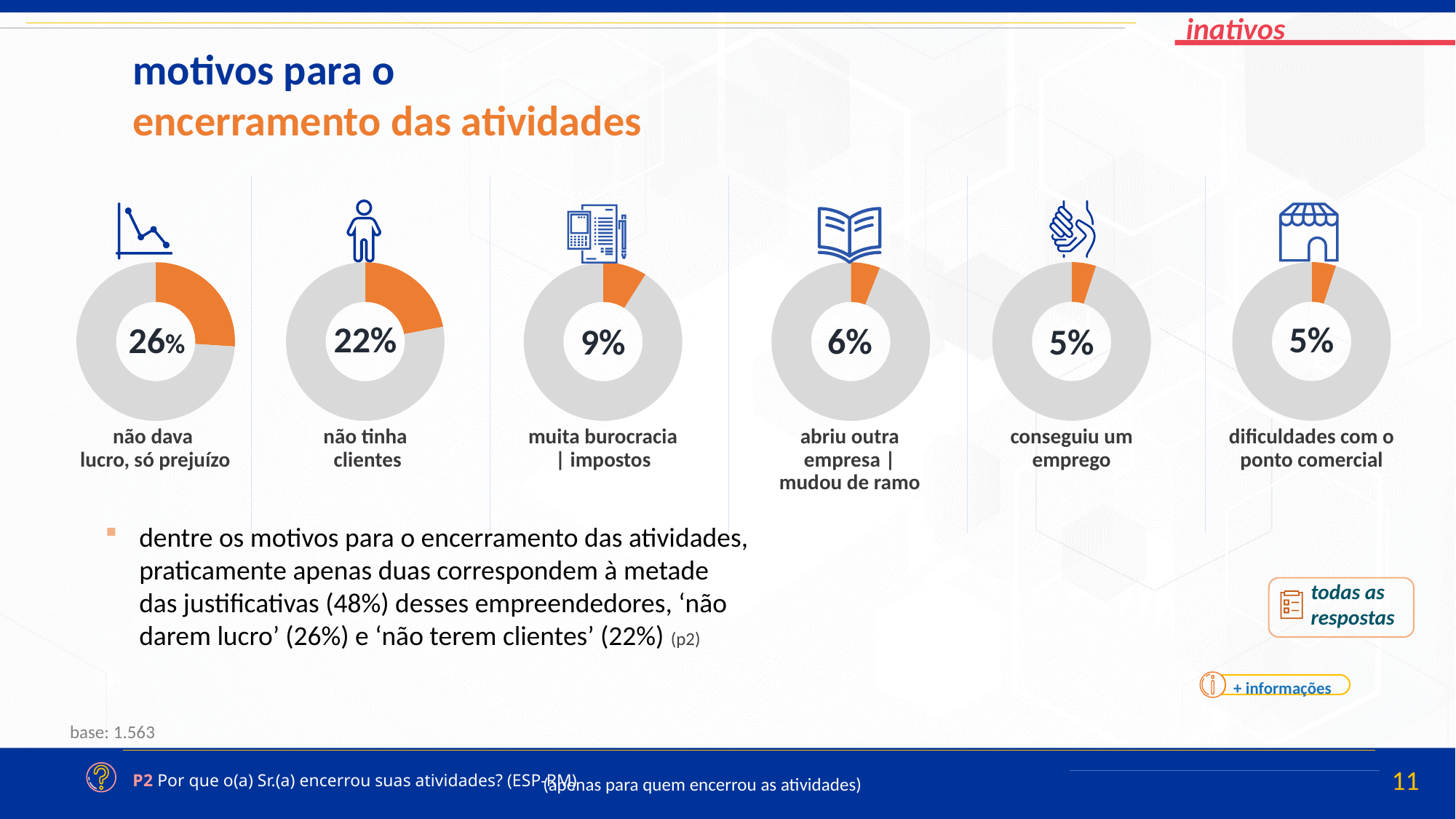
What percentage is shown in the donut chart labelled 'muita burocracia | impostos'? 9% What percentage is shown in the donut chart labelled 'não tinha clientes'? 22% What percentage is shown in the donut chart labelled 'não dava lucro, só prejuízo'? 26% What type of chart is used to display each percentage on the slide? Donut (pie) chart What is the combined percentage of the 'não dava lucro, só prejuízo' and 'não tinha clientes' charts? 48% What is the difference in percentage points between the 'não dava lucro, só prejuízo' chart and the 'não tinha clientes' chart? 4 Which is larger: the percentage for 'muita burocracia | impostos' or for 'abriu outra empresa | mudou de ramo'? muita burocracia | impostos How many donut charts are shown on the slide? 6 What colour is used for the highlighted slice in each donut chart? Orange Which reason for closing activities has the highest percentage among the donut charts? não dava lucro, só prejuízo What percentage is shown in the donut chart labelled 'conseguiu um emprego'? 5% What percentage is shown in the donut chart labelled 'abriu outra empresa | mudou de ramo'? 6%